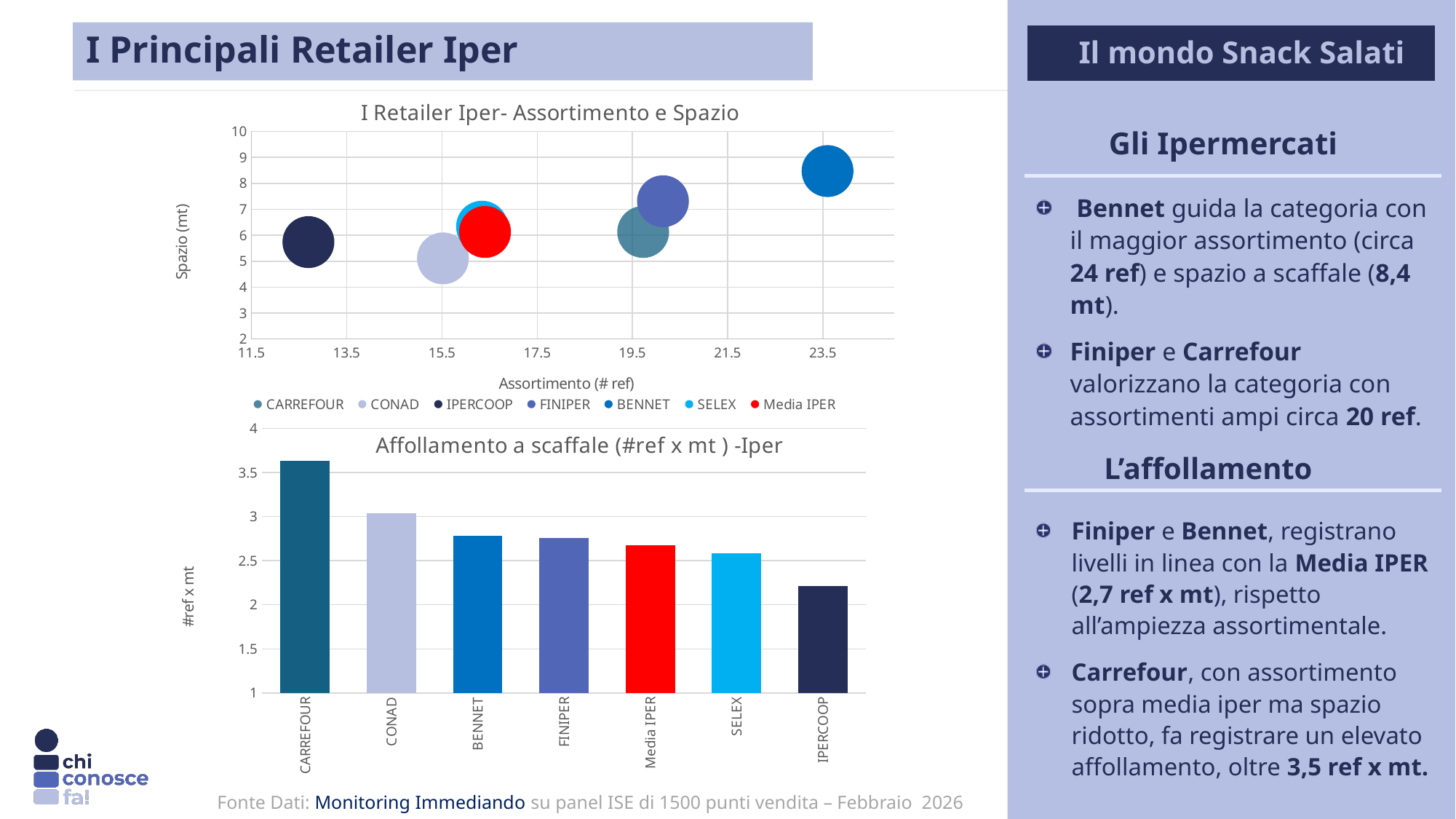
How many retailers are shown on the x axis of the bottom chart 'Affollamento a scaffale'? 7 In the bottom chart 'Affollamento a scaffale', which is larger, the value for CONAD or the value for SELEX? CONAD What kind of chart is the bottom chart titled 'Affollamento a scaffale (#ref x mt ) -Iper'? bar chart In the bottom chart 'Affollamento a scaffale', is the value for IPERCOOP greater or less than 2.5? less In the top chart 'I Retailer Iper- Assortimento e Spazio', is the Assortimento (# ref) for IPERCOOP greater or less than 13.5? less In the bottom chart 'Affollamento a scaffale', is the value for CARREFOUR greater or less than 3.5? greater How many series does the legend of the top chart 'I Retailer Iper- Assortimento e Spazio' list? 7 What kind of chart is the top chart titled 'I Retailer Iper- Assortimento e Spazio'? bubble chart In the bottom chart 'Affollamento a scaffale', which retailer has the lowest value? IPERCOOP In the top chart 'I Retailer Iper- Assortimento e Spazio', which retailer has the highest Spazio (mt)? BENNET In the bottom chart 'Affollamento a scaffale', which retailer has the highest value? CARREFOUR